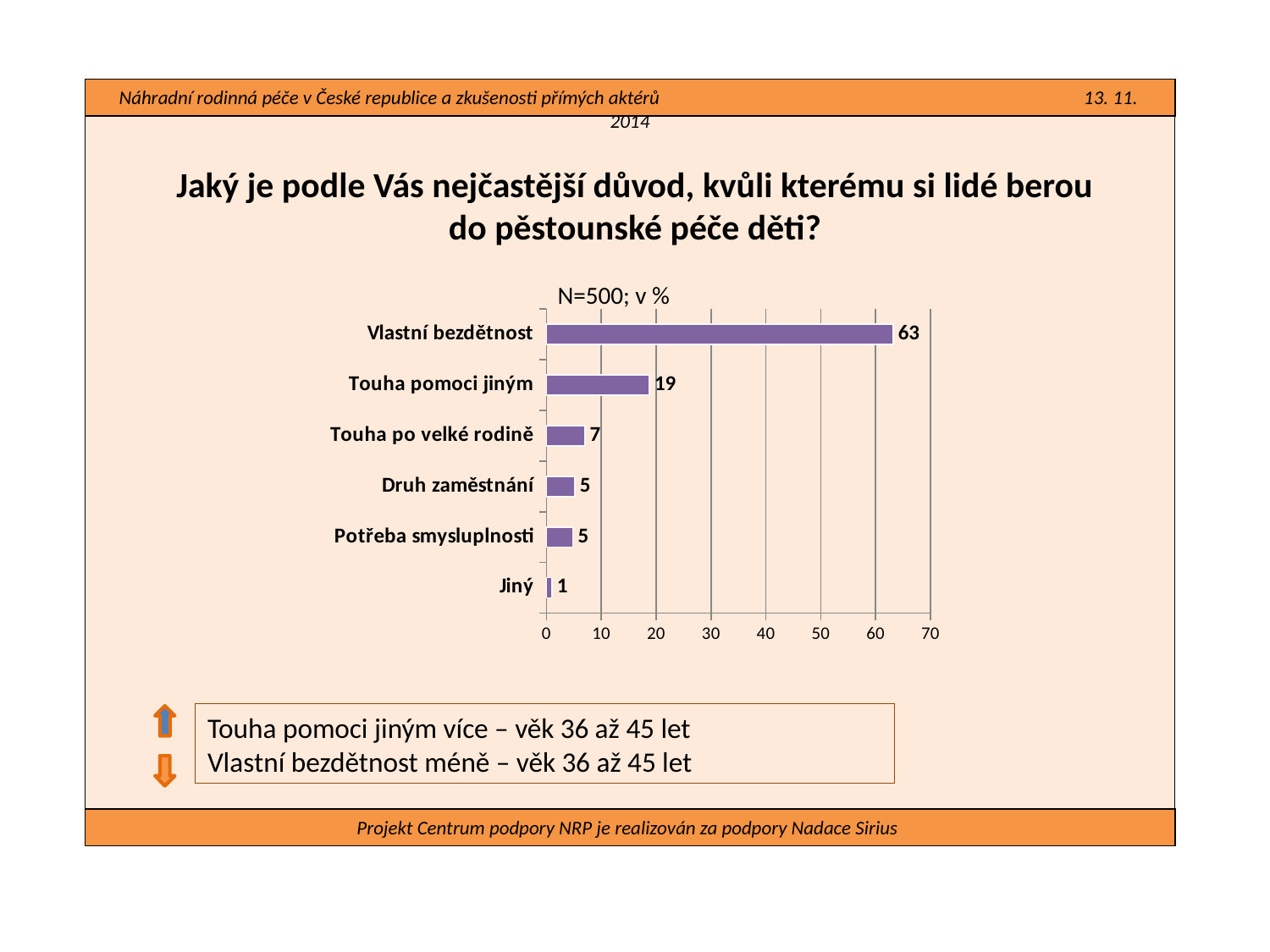
What kind of chart is shown on the slide? bar chart Which category has the highest value? Vlastní bezdětnost What is the difference between the values for Vlastní bezdětnost and Touha pomoci jiným? 44 Which is larger, the value for Touha po velké rodině or the value for Druh zaměstnání? Touha po velké rodině What is the value for Touha pomoci jiným? 19 How many categories are shown in the chart? 6 Is the value for Vlastní bezdětnost greater or less than 60? greater What is the value for Vlastní bezdětnost? 63 What sample size is stated above the chart? N=500 Which category has the lowest value? Jiný What is the value for Touha po velké rodině? 7 What is the value for Jiný? 1